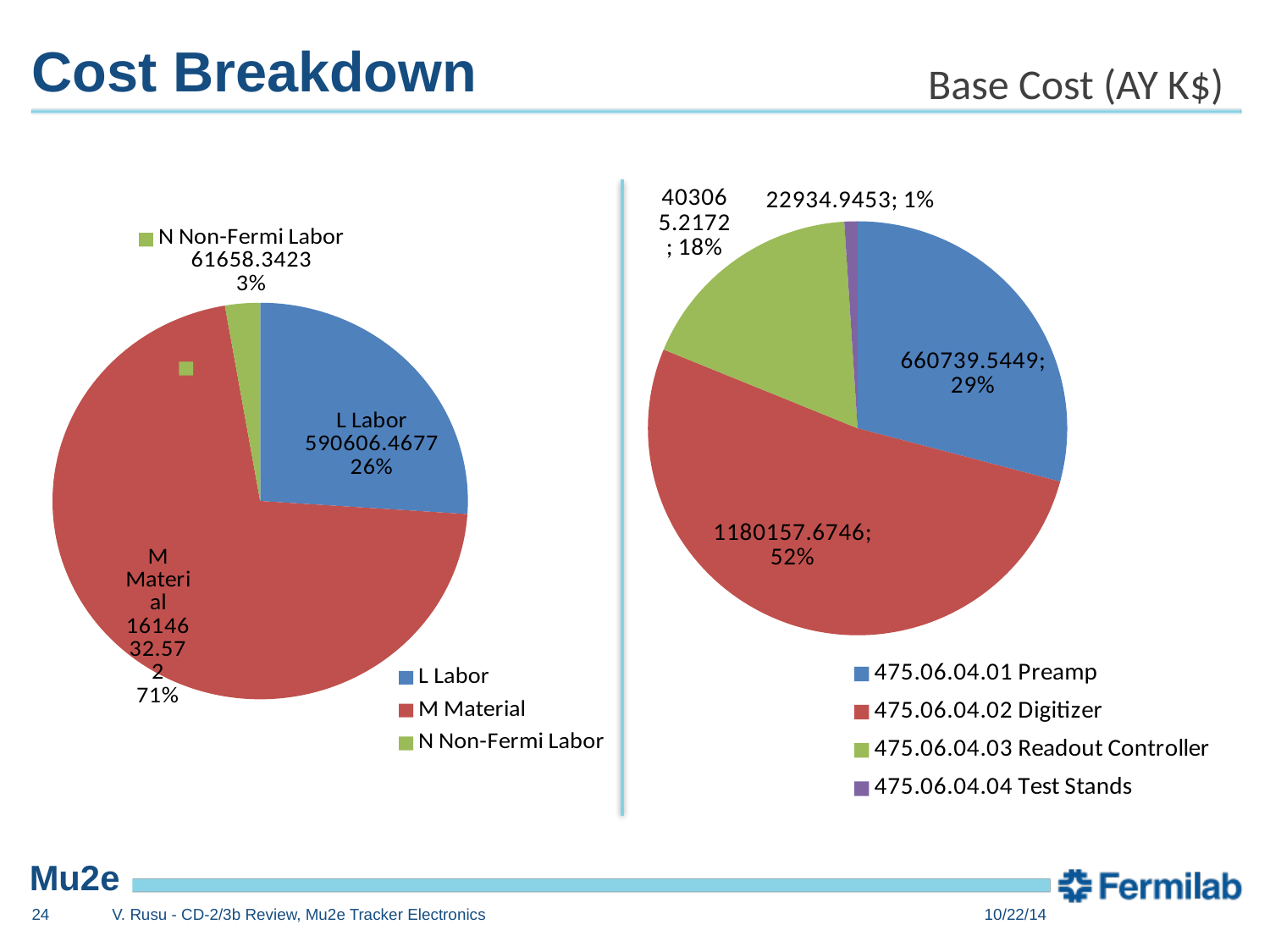
In the right pie chart, which category has the smallest share? 475.06.04.04 Test Stands In the left pie chart, which category has the largest share? M Material In the left pie chart, what percentage share does L Labor have? 26% In the right pie chart, what is the value shown for 475.06.04.04 Test Stands? 22934.9453 How many categories does the legend of the left pie chart list? 3 In the right pie chart, what is the value shown for 475.06.04.01 Preamp? 660739.5449 How many categories does the legend of the right pie chart list? 4 In the left pie chart, which category has the smallest share? N Non-Fermi Labor What type of chart is the left chart on the slide? pie chart In the right pie chart, what percentage share does 475.06.04.02 Digitizer have? 52% In the left pie chart, what is the value shown for L Labor? 590606.4677 In the left pie chart, what percentage share does N Non-Fermi Labor have? 3%